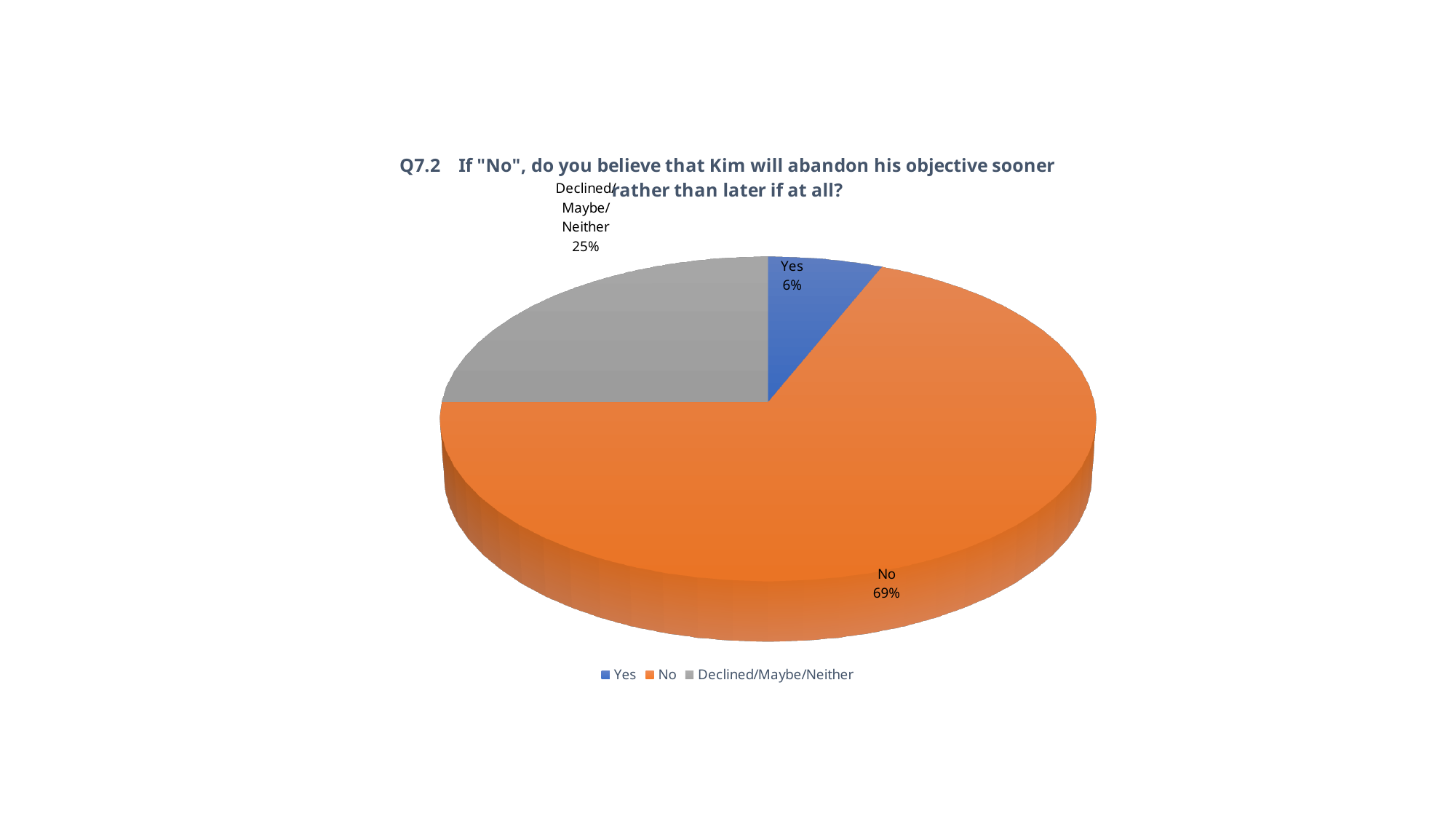
Which category has the largest slice of the pie? No What is the difference in percentage points between the "No" and "Declined/Maybe/Neither" slices? 44 What is the difference in percentage points between the "Declined/Maybe/Neither" and "Yes" slices? 19 What share of the pie does the "Declined/Maybe/Neither" slice represent? 25% Which category has the smallest slice of the pie? Yes What share of the pie does the "No" slice represent? 69% Which is larger, the "Yes" slice or the "Declined/Maybe/Neither" slice? Declined/Maybe/Neither What colour is the "No" slice in the pie chart? Orange How many entries does the legend list? 3 What share of the pie does the "Yes" slice represent? 6% How many slices does the pie chart have? 3 What kind of chart is shown on the slide? Pie chart